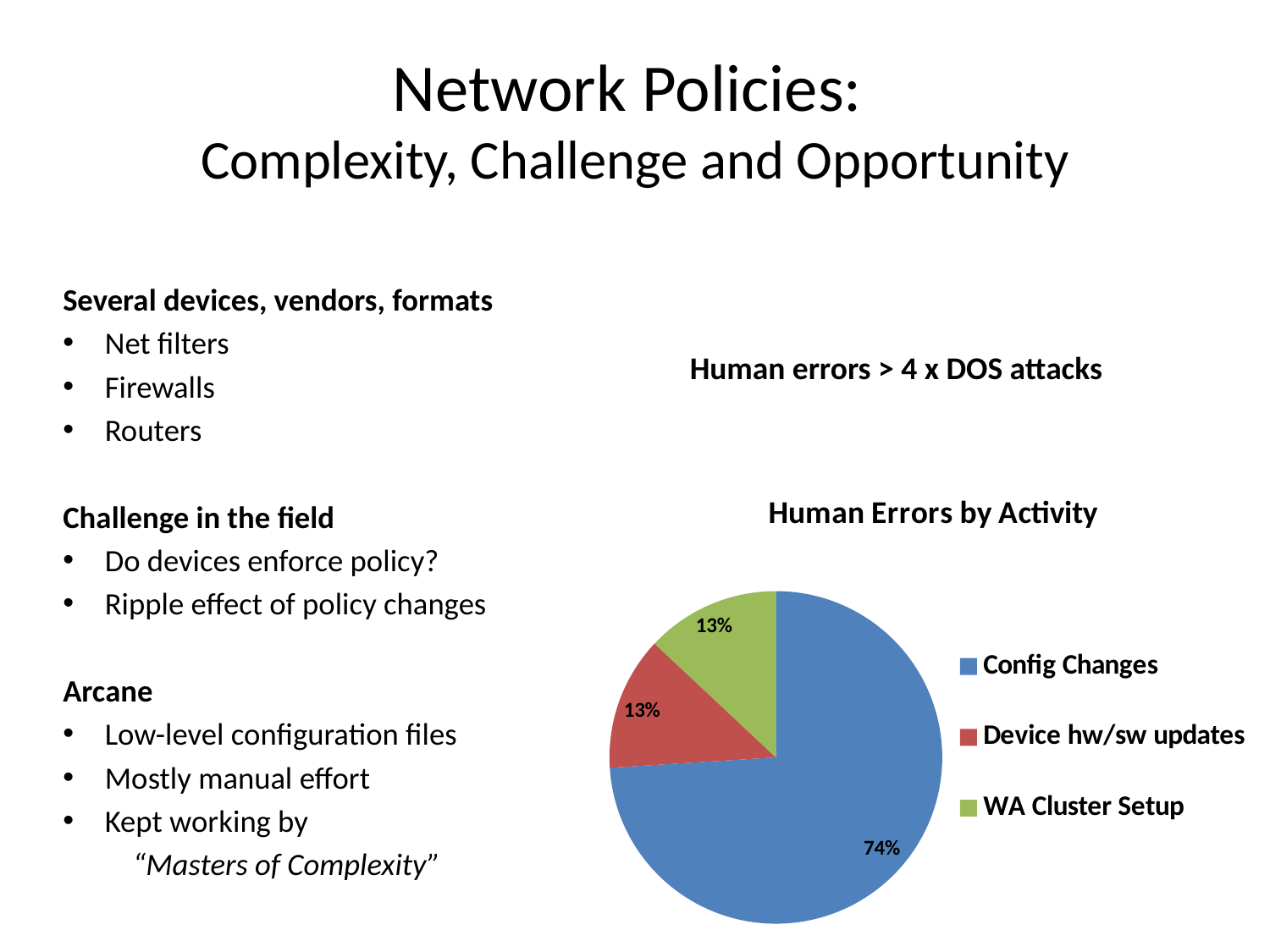
Which is larger: the share for Config Changes or the share for Device hw/sw updates? Config Changes What is the difference in percentage points between the Config Changes slice and the WA Cluster Setup slice? 61% What is the title of the chart? Human Errors by Activity What share of human errors is attributed to Config Changes? 74% Which colour represents WA Cluster Setup in the pie chart? green What share of human errors is attributed to WA Cluster Setup? 13% Is the share for Config Changes greater or less than 50%? greater How many activity categories does the pie chart show? 3 How many entries does the legend list? 3 What share of human errors is attributed to Device hw/sw updates? 13% What type of chart is shown on the slide? pie chart Which activity accounts for the largest share of human errors? Config Changes